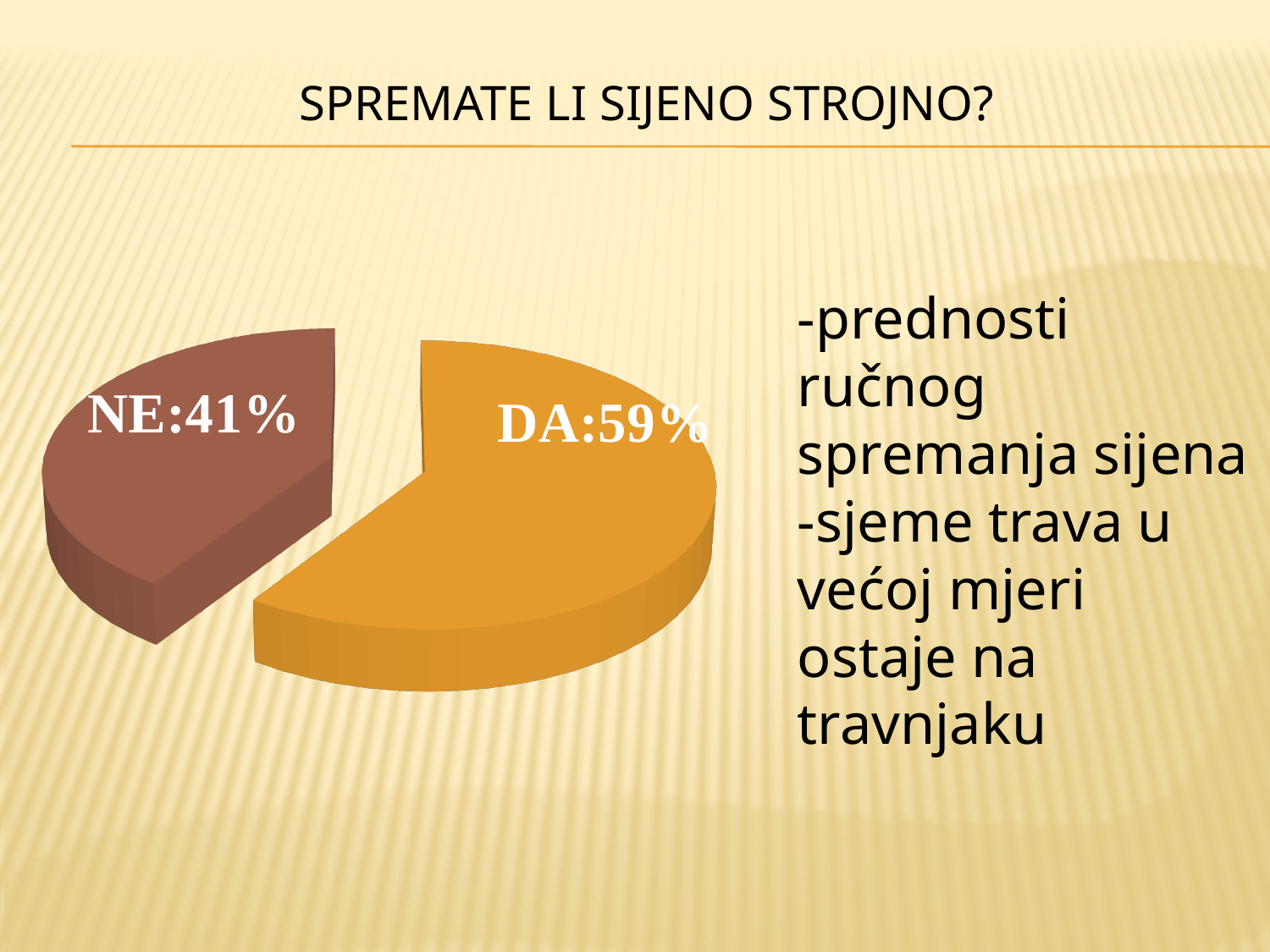
What is the title of the slide containing the pie chart? SPREMATE LI SIJENO STROJNO? How many slices does the pie chart have? 2 Which slice of the pie is the smallest? NE What kind of chart is shown on the slide? Pie chart Which slice of the pie is the largest? DA What share of the pie does the DA slice represent? 59% What is the difference in percentage points between the DA and NE slices? 18 Is the value for DA greater or less than 50%? greater Which is larger, the DA slice or the NE slice? DA What colour is the DA slice of the pie chart? Orange Is the value for NE greater or less than 50%? less What share of the pie does the NE slice represent? 41%